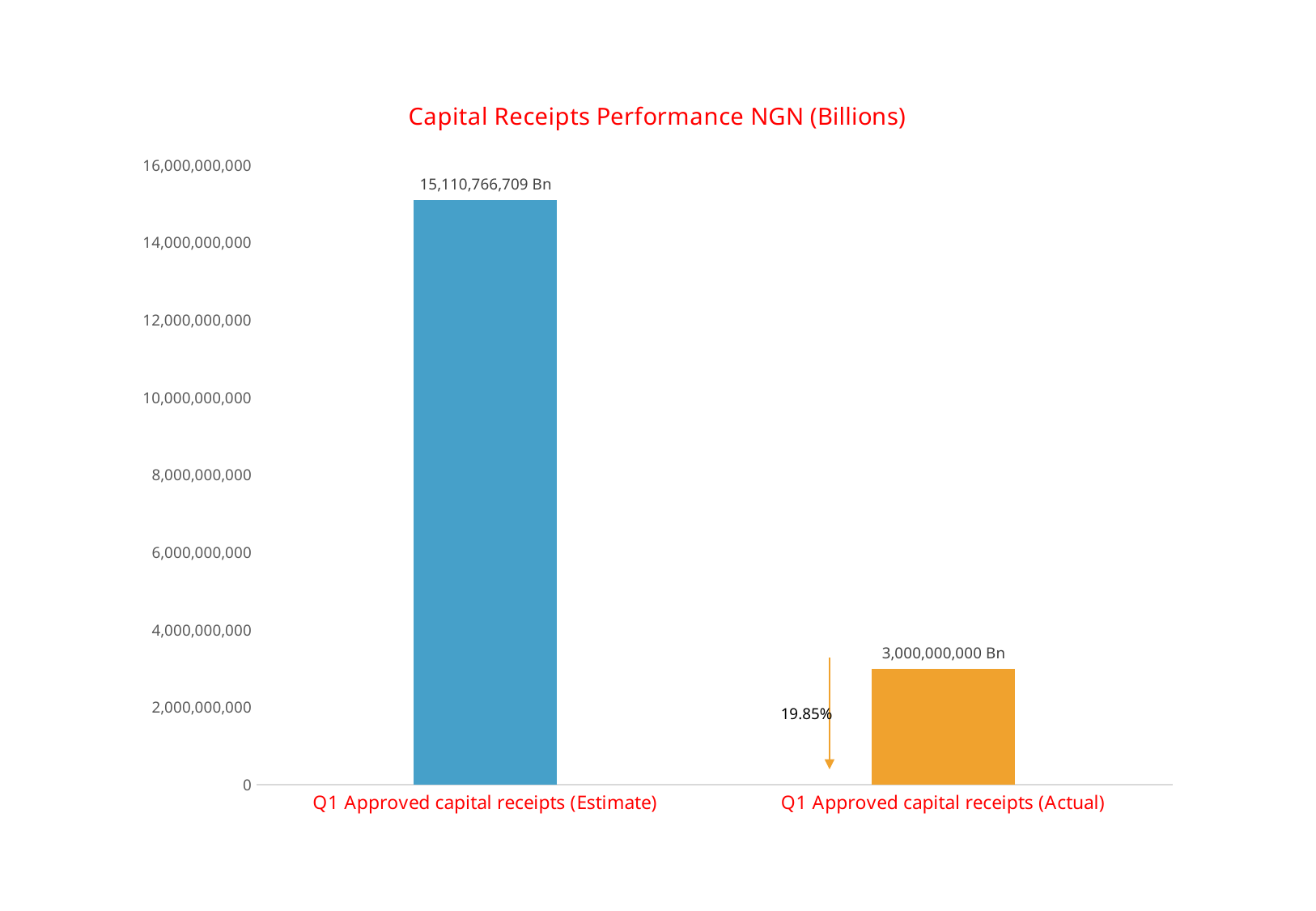
Is the value for Q1 Approved capital receipts (Actual) greater or less than 4,000,000,000? less What is the value for Q1 Approved capital receipts (Estimate)? 15,110,766,709 Bn Is the value for Q1 Approved capital receipts (Estimate) greater or less than 14,000,000,000? greater How many categories are shown on the chart? 2 What is the title of the chart? Capital Receipts Performance NGN (Billions) What percentage is shown next to the arrow beside the Actual bar? 19.85% What kind of chart is shown on the slide? Bar chart What is the value for Q1 Approved capital receipts (Actual)? 3,000,000,000 Bn Which is larger, the Estimate or the Actual value? Q1 Approved capital receipts (Estimate) Which category has the highest value? Q1 Approved capital receipts (Estimate) Which category has the lowest value? Q1 Approved capital receipts (Actual) What is the difference between the Estimate and Actual values? 12,110,766,709 Bn